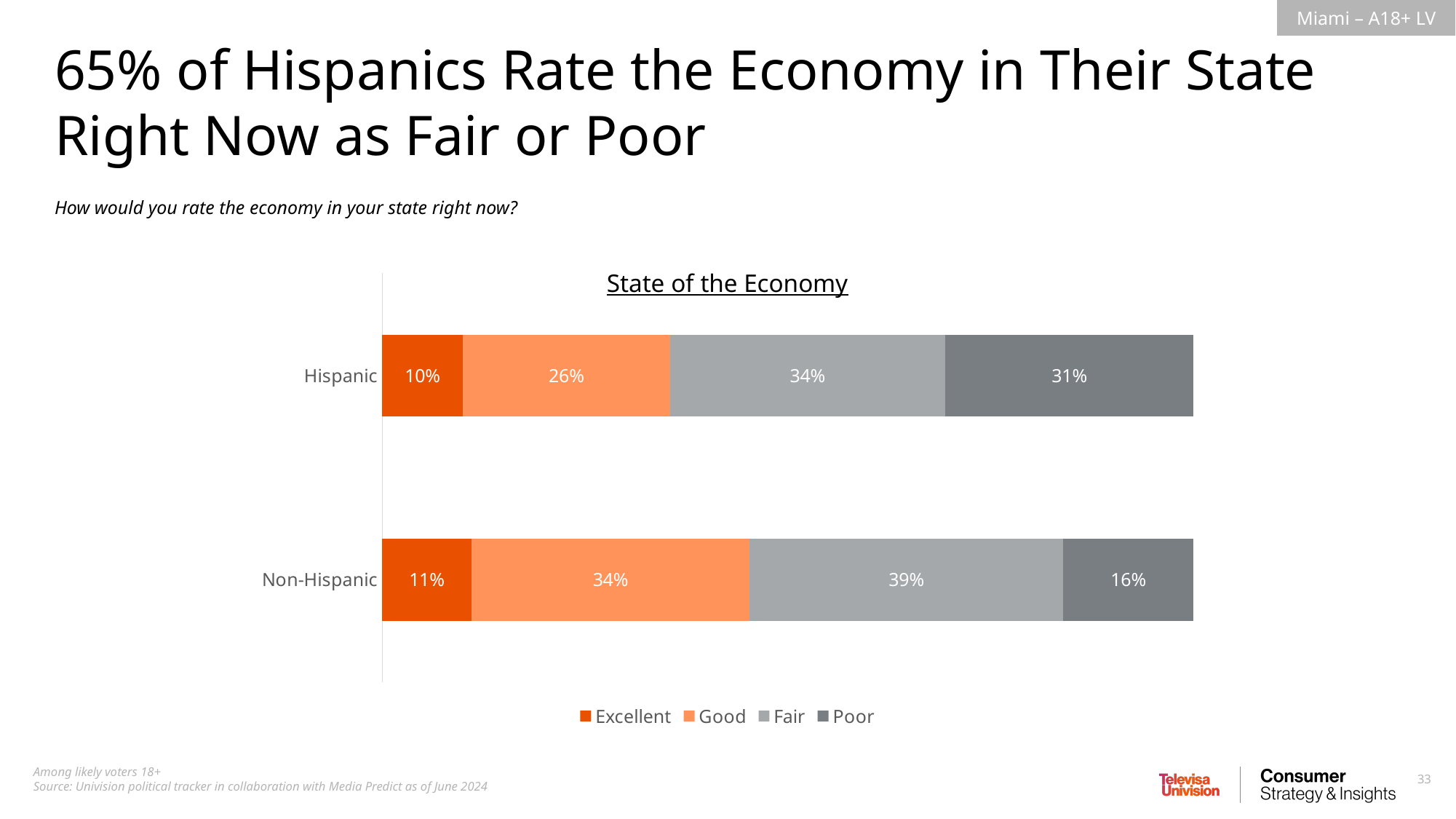
Which rating category has the largest share among Hispanic respondents? Fair What is the difference between the Poor share for Hispanic and Non-Hispanic respondents? 15 percentage points How many series does the legend list? 4 What percentage of Hispanic respondents rate the economy in their state as Poor? 31% Which rating category has the smallest share among Non-Hispanic respondents? Excellent What percentage of Non-Hispanic respondents rate the economy as Fair? 39% What kind of chart is shown on the slide? Stacked bar chart What is the title of the chart? State of the Economy What is the combined Fair and Poor share for Hispanic respondents? 65% Which group has a larger share rating the economy as Good, Hispanic or Non-Hispanic? Non-Hispanic What percentage of Non-Hispanic respondents rate the economy in their state as Good? 34% What percentage of Hispanic respondents rate the economy as Excellent? 10%